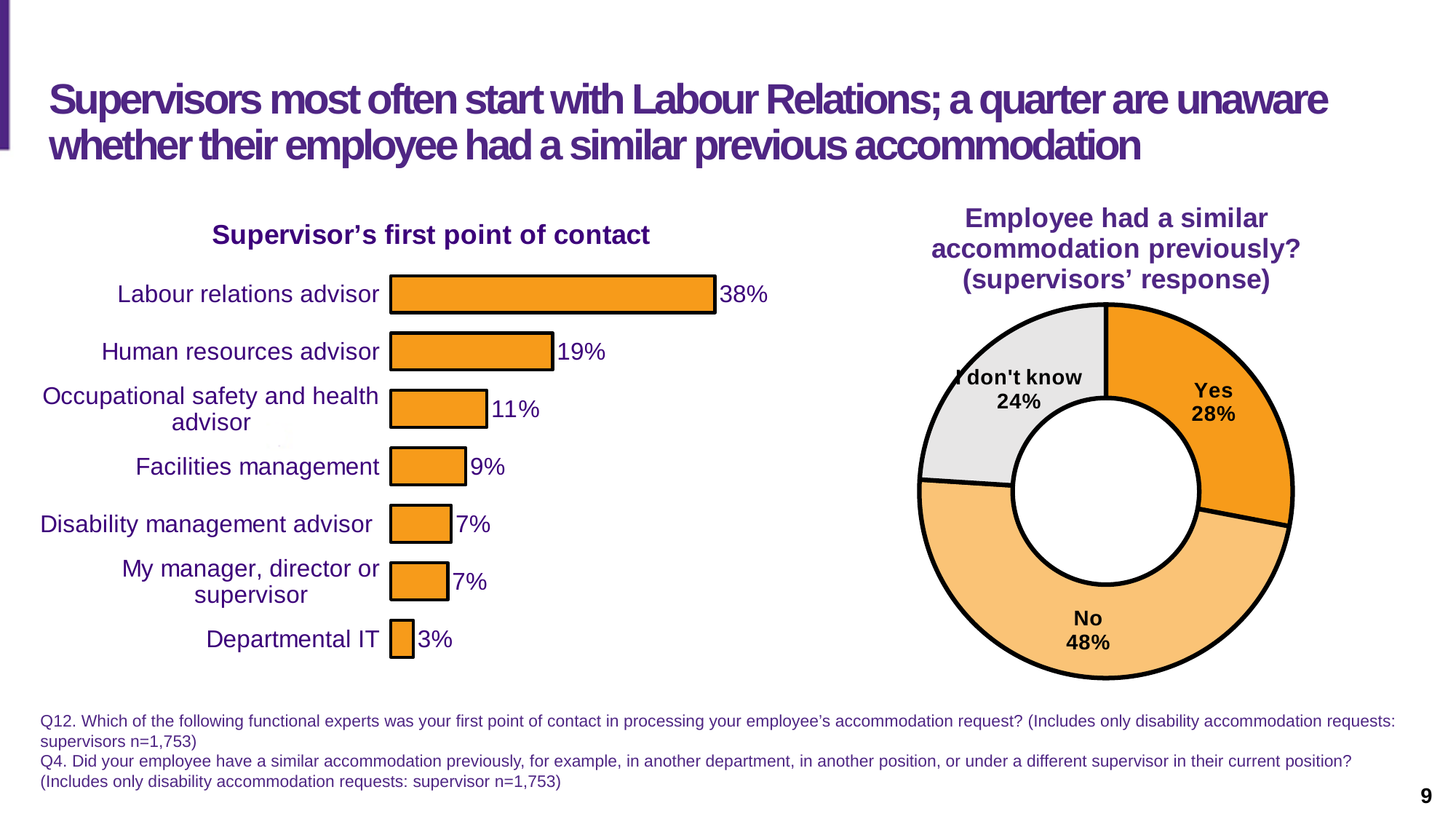
In the 'Supervisor's first point of contact' chart, which category has the lowest value? Departmental IT In the 'Supervisor's first point of contact' chart, which category has the highest value? Labour relations advisor In the 'Supervisor's first point of contact' chart, what is the value for Labour relations advisor? 38% How many categories are shown in the 'Supervisor's first point of contact' chart? 7 In the 'Supervisor's first point of contact' chart, what is the difference between Labour relations advisor and Human resources advisor? 19% In the 'Employee had a similar accommodation previously?' chart, which response has the largest share? No What kind of chart is the 'Supervisor's first point of contact' chart? Bar chart In the 'Employee had a similar accommodation previously?' chart, what is the value for 'I don't know'? 24% In the 'Employee had a similar accommodation previously?' chart, what is the difference between 'Yes' and 'I don't know'? 4% In the 'Employee had a similar accommodation previously?' chart, what share of responses is 'No'? 48% In the 'Supervisor's first point of contact' chart, which is larger: Occupational safety and health advisor or Facilities management? Occupational safety and health advisor In the 'Supervisor's first point of contact' chart, what is the value for Human resources advisor? 19%